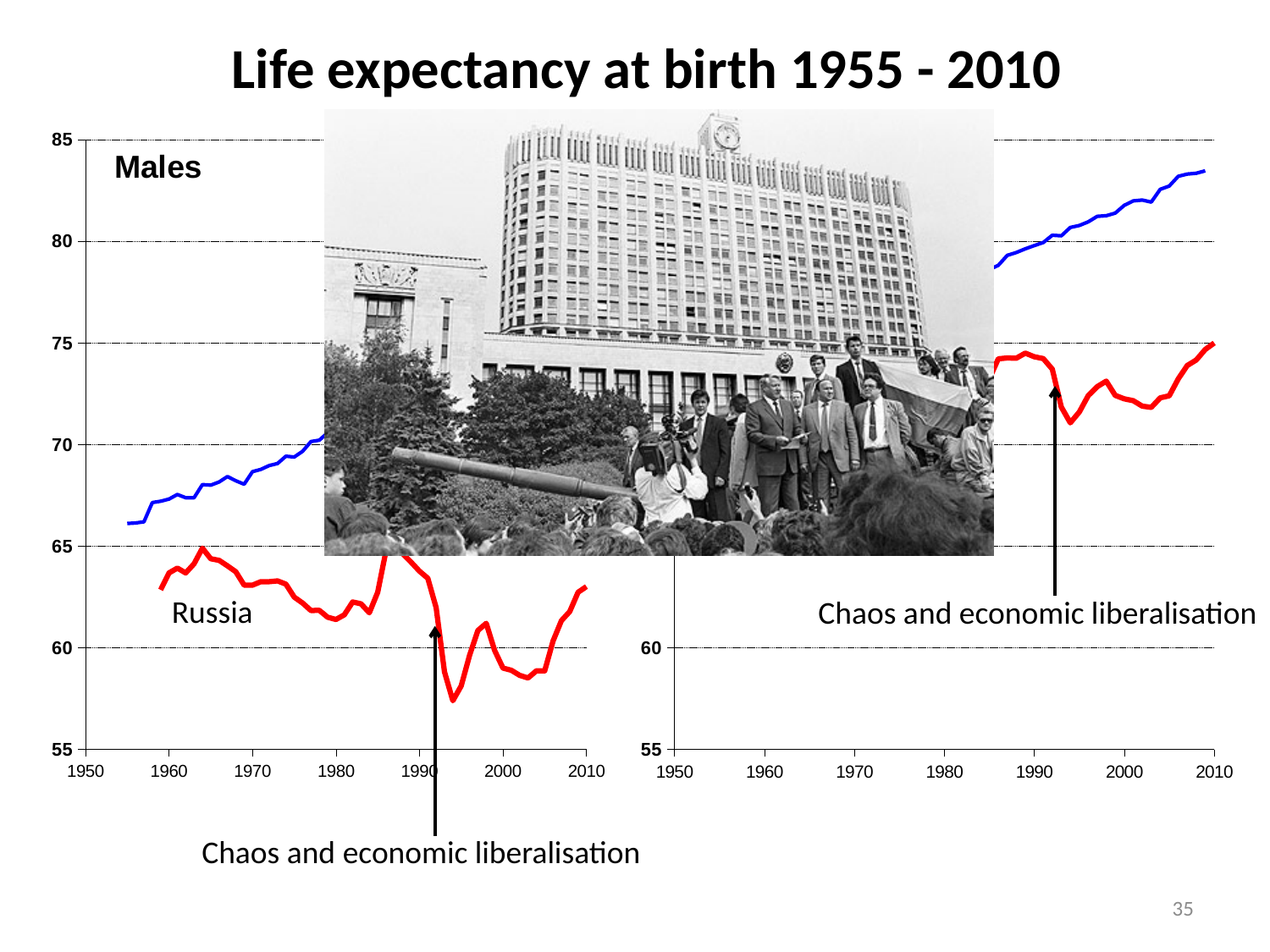
In the left chart (Males), what colour is the line labelled Russia? red In the left chart (Males), is the value of the blue line in 1960 greater or less than 65? greater In the left chart (Males), does the blue line generally rise or fall from 1955 to 1980? rise In the right chart, is the value of the blue line in 2010 greater or less than 80? greater In the left chart (Males), is the value of the Russia line in 2010 greater or less than 60? greater How many charts are shown on the slide? 2 In the right chart, does the blue line rise or fall between 1990 and 2010? rise What is the title of the slide's chart? Life expectancy at birth 1955 - 2010 What type of chart is the left chart labelled Males? line chart